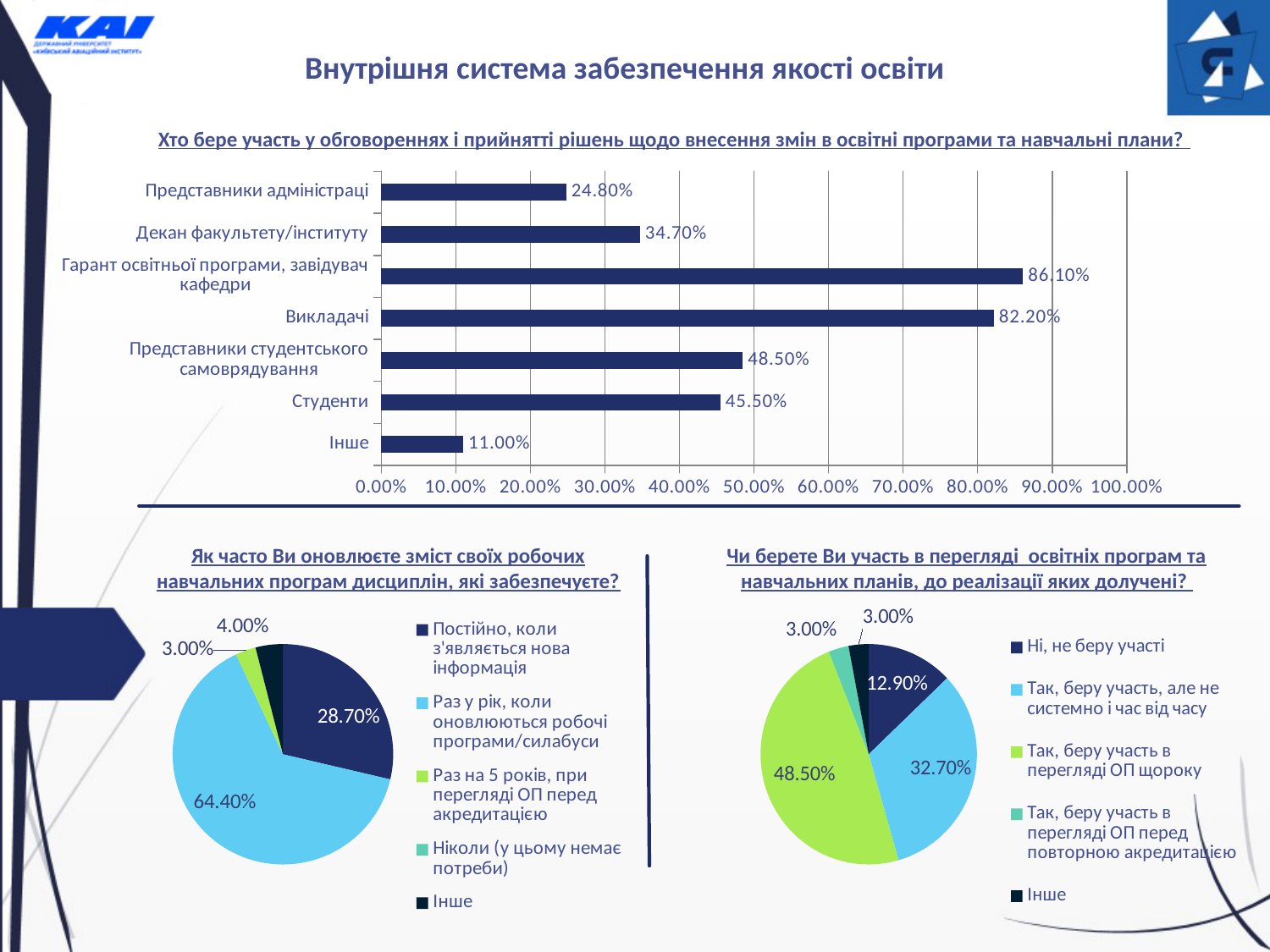
In the bar chart 'Хто бере участь у обговореннях і прийнятті рішень щодо внесення змін в освітні програми та навчальні плани?', what is the value for Викладачі? 82.20% In the bar chart 'Хто бере участь у обговореннях...', what is the value for Студенти? 45.50% In the pie chart 'Як часто Ви оновлюєте зміст...', what share is 'Постійно, коли з'являється нова інформація'? 28.70% In the bar chart 'Хто бере участь у обговореннях...', what is the difference between the values for Декан факультету/інституту and Представники адміністраці? 9.90% In the pie chart 'Як часто Ви оновлюєте зміст своїх робочих навчальних програм дисциплін, які забезпечуєте?', what share is 'Раз у рік, коли оновлюються робочі програми/силабуси'? 64.40% What type of chart is the top chart 'Хто бере участь у обговореннях...'? Bar chart How many entries does the legend of the pie chart 'Чи берете Ви участь в перегляді освітніх програм...' list? 5 In the pie chart 'Чи берете Ви участь в перегляді освітніх програм та навчальних планів, до реалізації яких долучені?', what share is 'Так, беру участь в перегляді ОП щороку'? 48.50% How many categories does the bar chart 'Хто бере участь у обговореннях...' show? 7 In the bar chart 'Хто бере участь у обговореннях...', which is larger: Представники студентського самоврядування or Студенти? Представники студентського самоврядування In the bar chart 'Хто бере участь у обговореннях...', which category has the highest value? Гарант освітньої програми, завідувач кафедри In the bar chart 'Хто бере участь у обговореннях...', which category has the lowest value? Інше